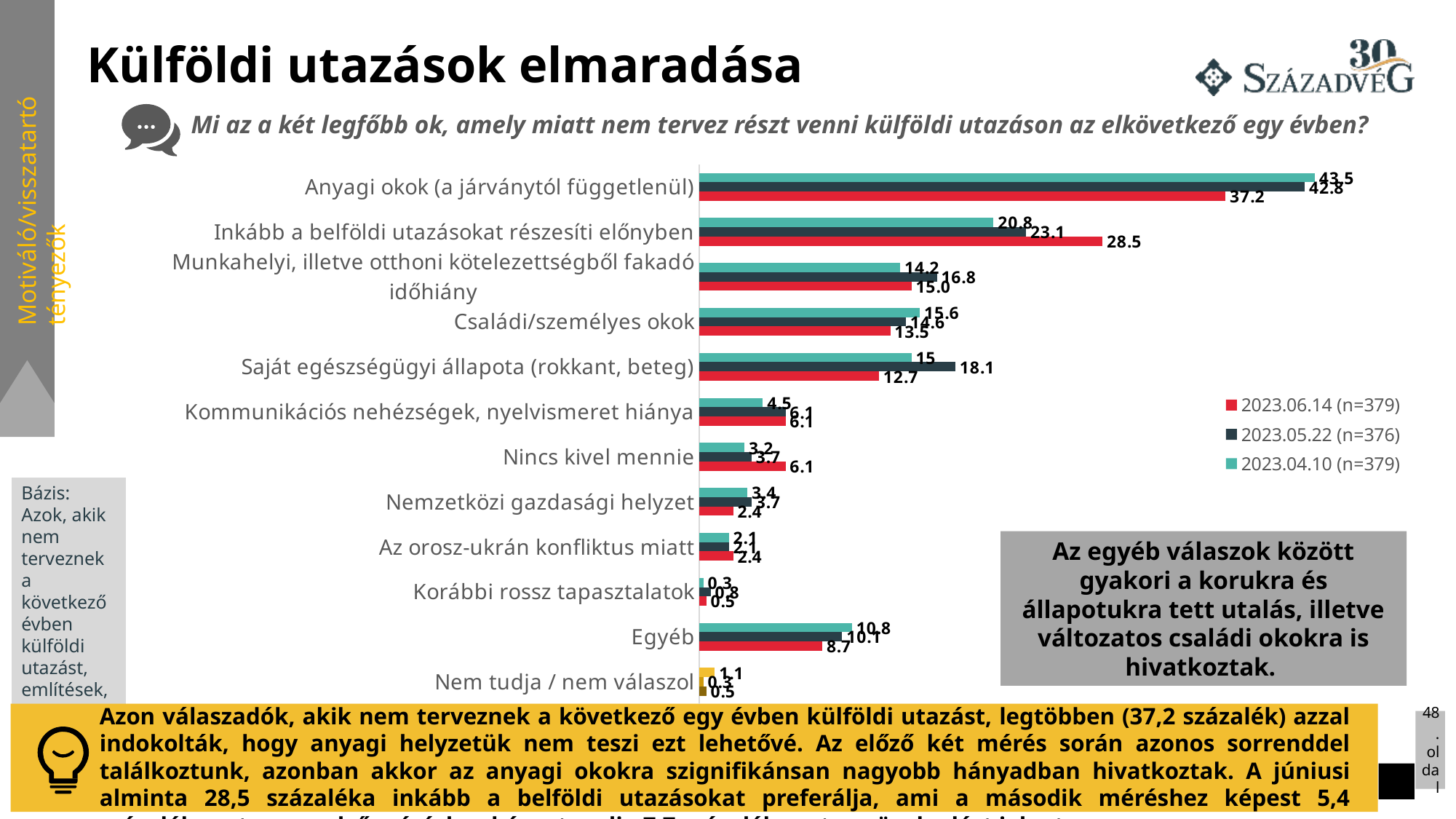
What type of chart is shown on the slide? bar chart How many series does the legend list? 3 What is the value for "Inkább a belföldi utazásokat részesíti előnyben" in the 2023.06.14 (n=379) series? 28.5 Which category has the highest value in the 2023.06.14 (n=379) series? Anyagi okok (a járványtól függetlenül) What is the value for "Saját egészségügyi állapota (rokkant, beteg)" in the 2023.05.22 (n=376) series? 18.1 How many categories are shown on the chart? 12 What is the value for "Egyéb" in the 2023.04.10 (n=379) series? 10.8 For "Inkább a belföldi utazásokat részesíti előnyben", which series has the larger value: 2023.06.14 (n=379) or 2023.04.10 (n=379)? 2023.06.14 (n=379) Which colour represents the 2023.06.14 (n=379) series in the chart? red What is the value for "Anyagi okok (a járványtól függetlenül)" in the 2023.06.14 (n=379) series? 37.2 What is the difference between the 2023.04.10 (n=379) and 2023.06.14 (n=379) values for "Anyagi okok (a járványtól függetlenül)"? 6.3 What is the difference between the 2023.06.14 (n=379) and 2023.05.22 (n=376) values for "Inkább a belföldi utazásokat részesíti előnyben"? 5.4